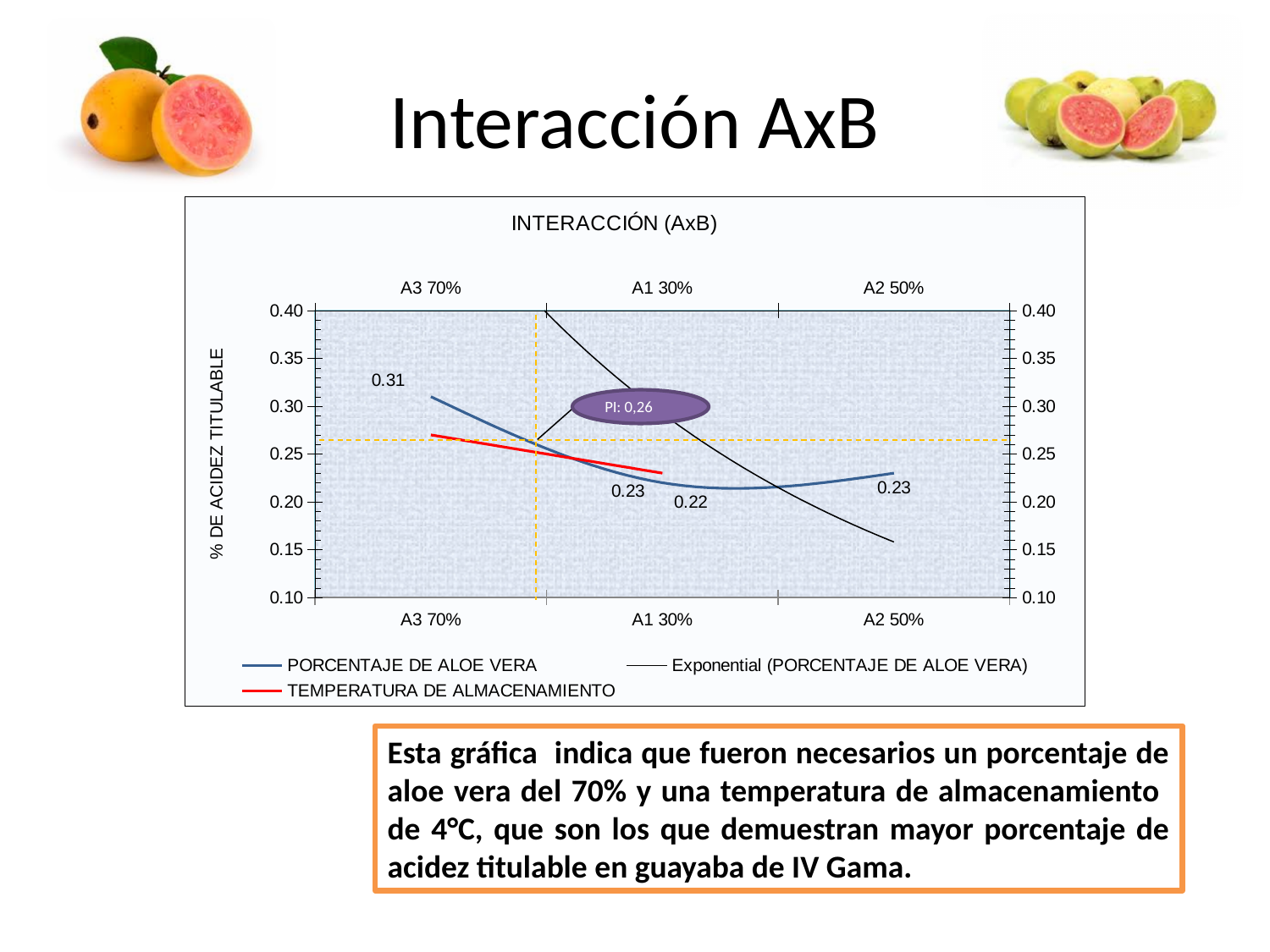
What is the value of PORCENTAJE DE ALOE VERA at A2 50%? 0.23 What is the value of PORCENTAJE DE ALOE VERA at A3 70%? 0.31 What type of chart is shown on the slide? line chart What is the title of the chart? INTERACCIÓN (AxB) Does the PORCENTAJE DE ALOE VERA line rise or fall from A3 70% to A1 30%? fall Which is larger, the PORCENTAJE DE ALOE VERA value at A3 70% or at A2 50%? A3 70% Which category has the highest value for PORCENTAJE DE ALOE VERA? A3 70% How many series does the chart legend list? 3 Is the value of TEMPERATURA DE ALMACENAMIENTO at A3 70% greater or less than 0.25? greater What is the label of the vertical axis of the chart? % DE ACIDEZ TITULABLE What is the difference between the PORCENTAJE DE ALOE VERA values at A3 70% and A2 50%? 0.08 How many categories are shown on the x axis of the chart? 3